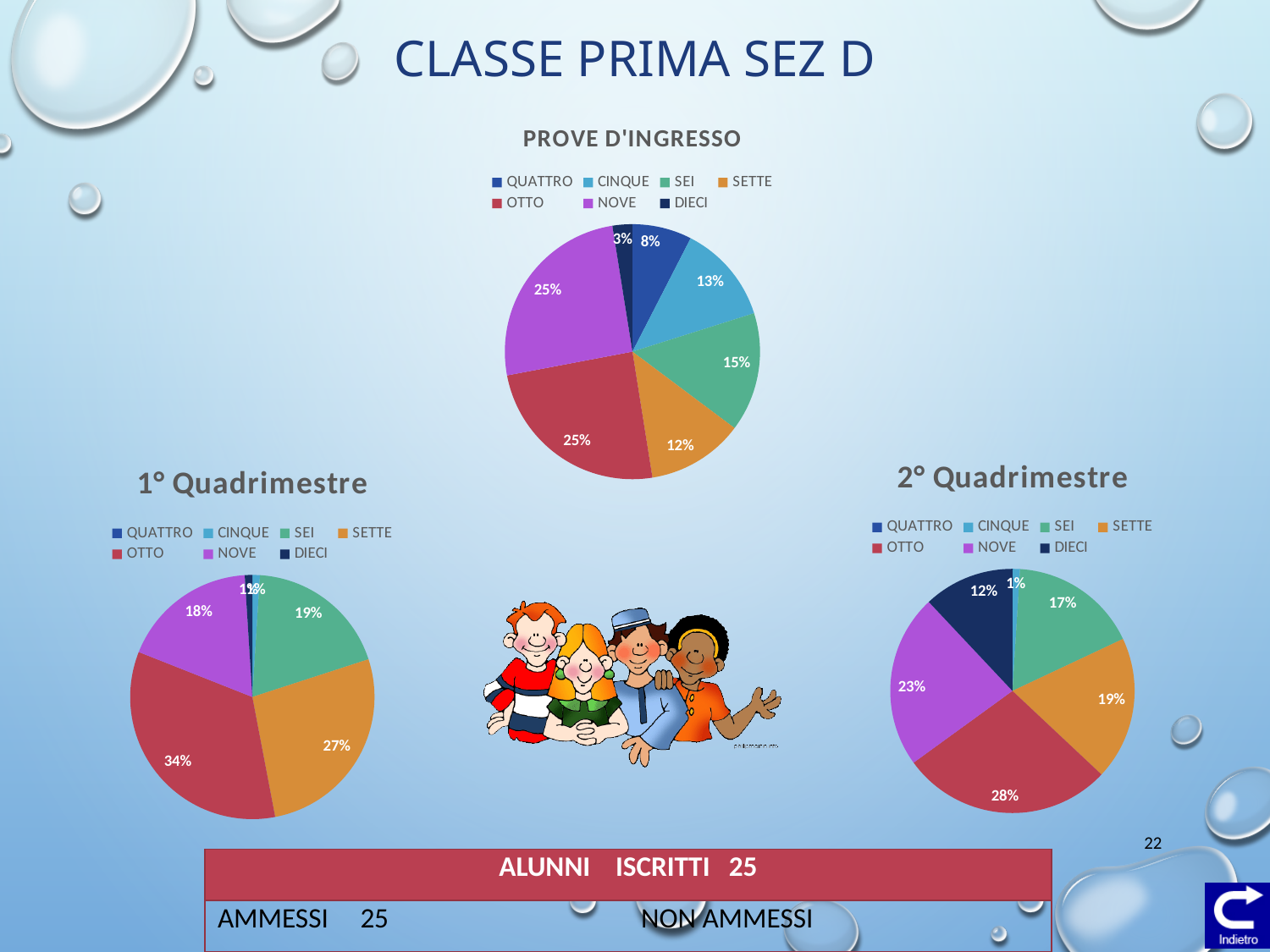
In the 1° Quadrimestre chart, which is larger, SEI or NOVE? SEI In the PROVE D'INGRESSO chart, what percentage is shown for CINQUE? 13% How many entries does the legend of the 2° Quadrimestre chart list? 7 What type of chart is the PROVE D'INGRESSO chart? Pie chart In the 1° Quadrimestre chart, which category has the largest slice? OTTO In the 1° Quadrimestre chart, what percentage is shown for SETTE? 27% In the PROVE D'INGRESSO chart, what share of the pie is SEI? 15% In the 2° Quadrimestre chart, what percentage is shown for DIECI? 12% In the 2° Quadrimestre chart, which category has the largest share? OTTO In the PROVE D'INGRESSO chart, what is the difference in percentage points between OTTO and SETTE? 13 percentage points In the 2° Quadrimestre chart, what is the difference in percentage points between OTTO and NOVE? 5 percentage points In the PROVE D'INGRESSO chart, which category has the smallest slice? DIECI